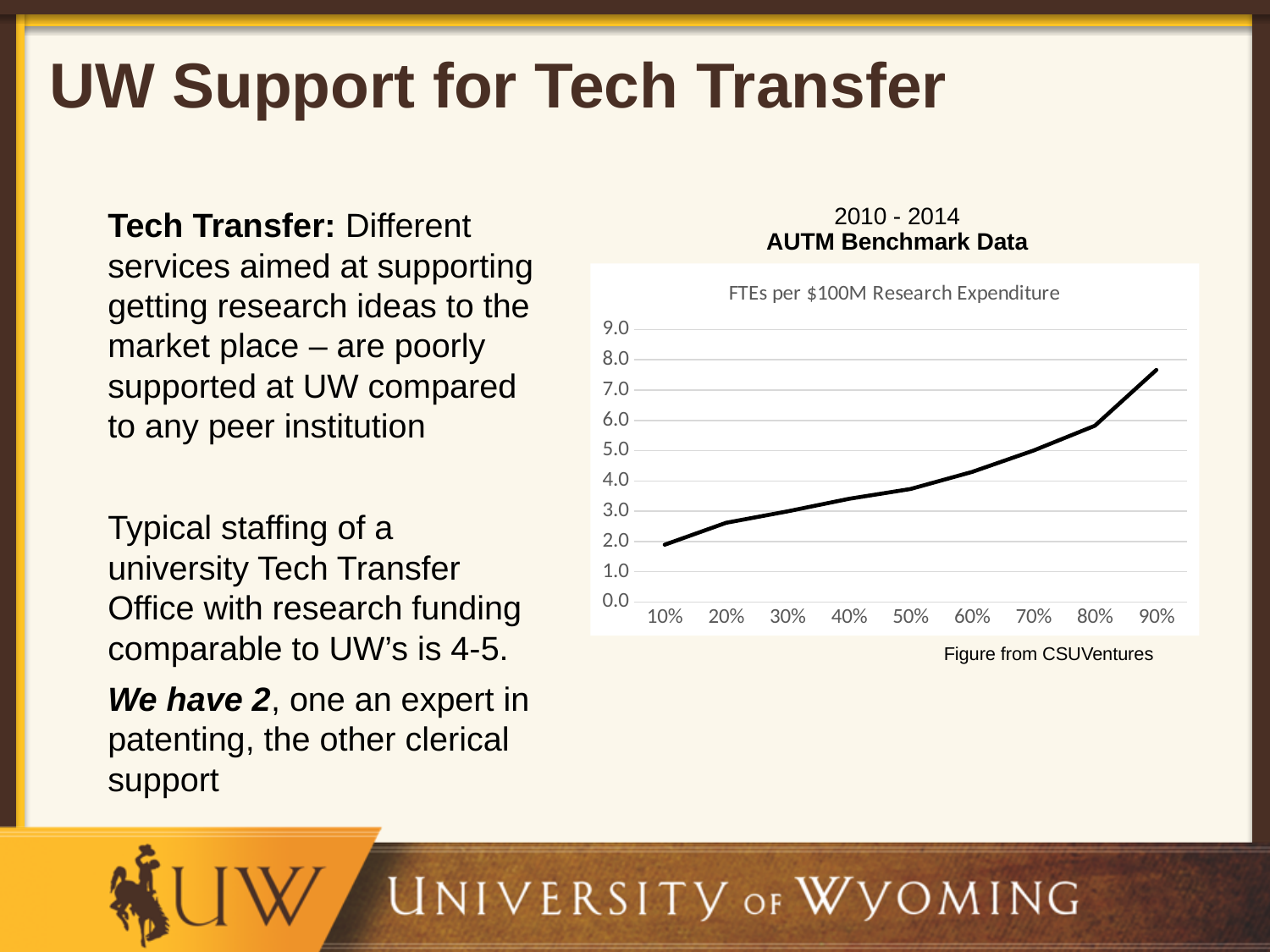
How many points are plotted along the x axis of the chart? 9 Do the values rise or fall as you move from 10% to 90% along the x axis? rise Is the value at 80% greater or less than 5.0? greater What kind of chart is shown on the slide? line chart What is the title of the chart? FTEs per $100M Research Expenditure Which is larger, the value at 70% or the value at 30%? 70% Is the value at 20% greater or less than 2.0? greater According to the caption, where is the figure from? CSUVentures At which x-axis percentile is the value lowest? 10% At which x-axis percentile is the value highest? 90% Is the value at 90% greater or less than 7.0? greater